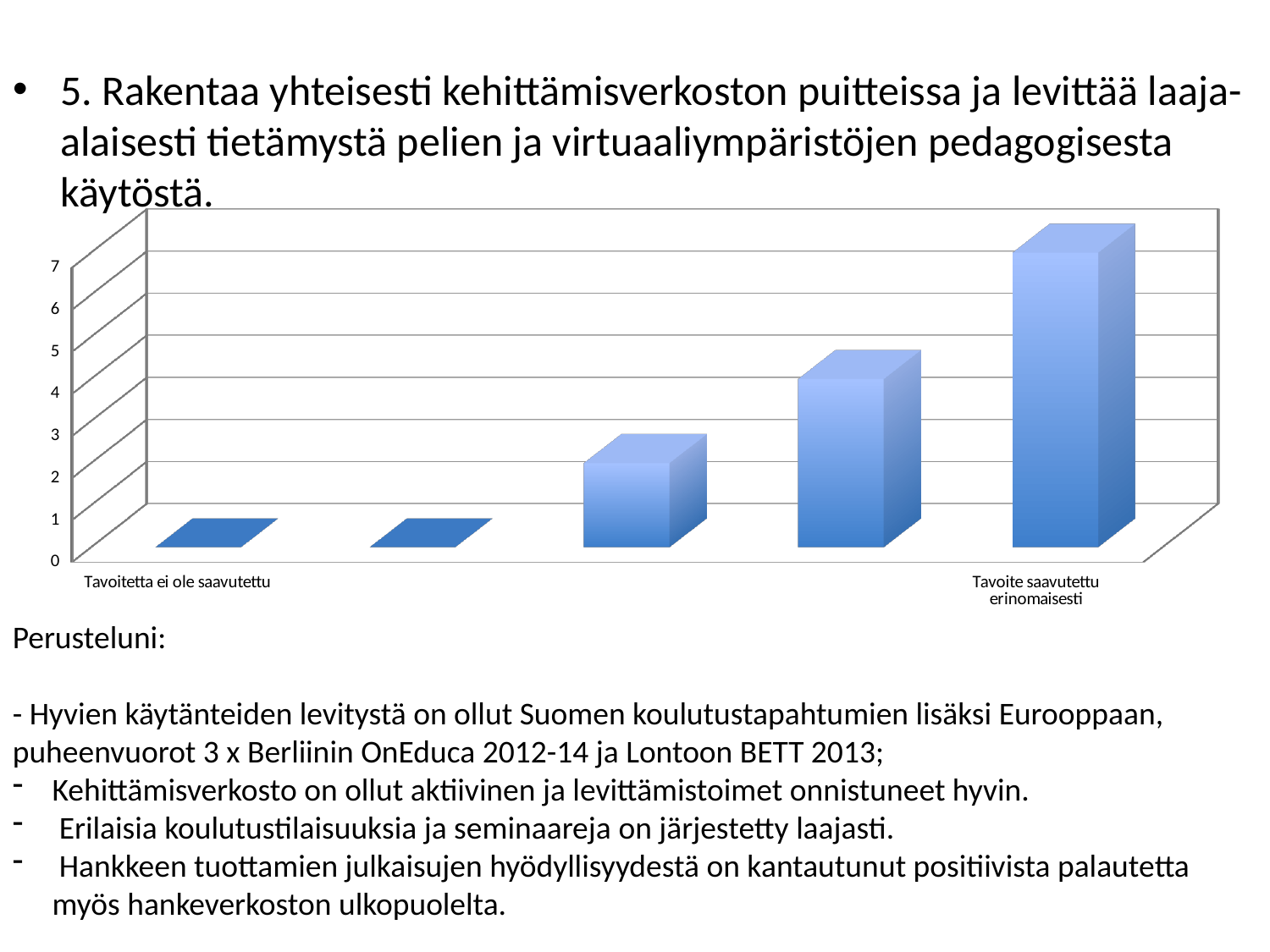
What is the highest value shown on the vertical axis of the chart? 7 What is the value of the bar for 'Tavoitetta ei ole saavutettu'? 0 Is the value for 'Tavoite saavutettu erinomaisesti' greater or less than 5? greater What kind of chart is shown on the slide? bar chart Is the value of the middle bar greater or less than 3? less Which is larger, the bar for 'Tavoitetta ei ole saavutettu' or the bar for 'Tavoite saavutettu erinomaisesti'? Tavoite saavutettu erinomaisesti Do the bar values rise or fall from left to right across the chart? rise Is the value of the middle bar greater or less than 1? greater How many bars does the chart contain? 5 Which category has the highest bar in the chart? Tavoite saavutettu erinomaisesti How many bars in the chart have a value of 0? 2